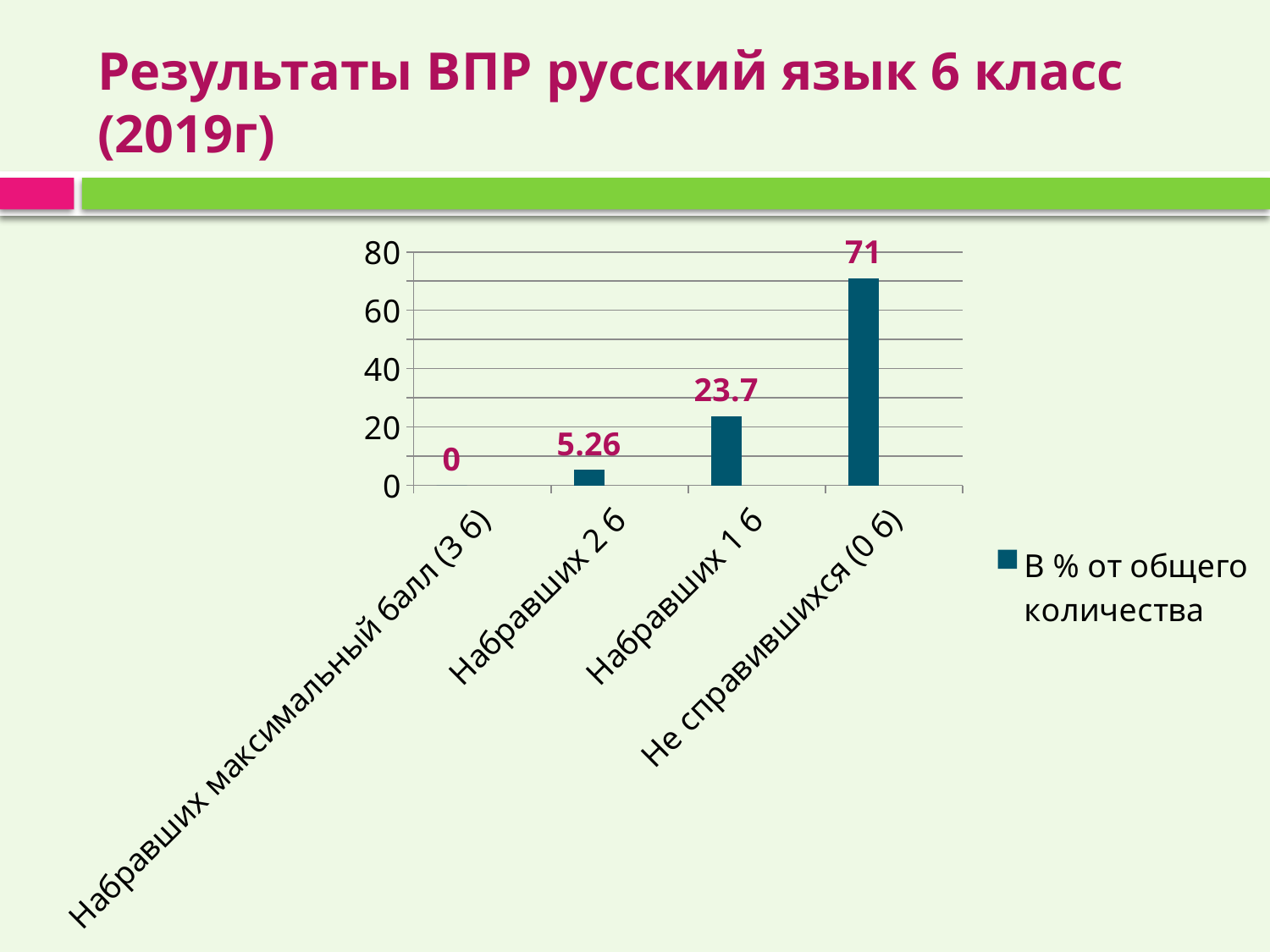
Which category has the lowest value? Набравших максимальный балл (3 б) Which category has the highest value? Не справившихся (0 б) What is the value for 'Набравших 2 б'? 5.26 What is the value for 'Набравших 1 б'? 23.7 What is the legend entry for the series shown? В % от общего количества What kind of chart is shown on the slide? bar chart How many categories are shown on the x axis? 4 Is the value for 'Не справившихся (0 б)' greater or less than 60? greater Which is larger, the value for 'Набравших 2 б' or the value for 'Набравших 1 б'? Набравших 1 б What is the value for 'Набравших максимальный балл (3 б)'? 0 What is the value for 'Не справившихся (0 б)'? 71 What is the difference between the values for 'Не справившихся (0 б)' and 'Набравших 1 б'? 47.3